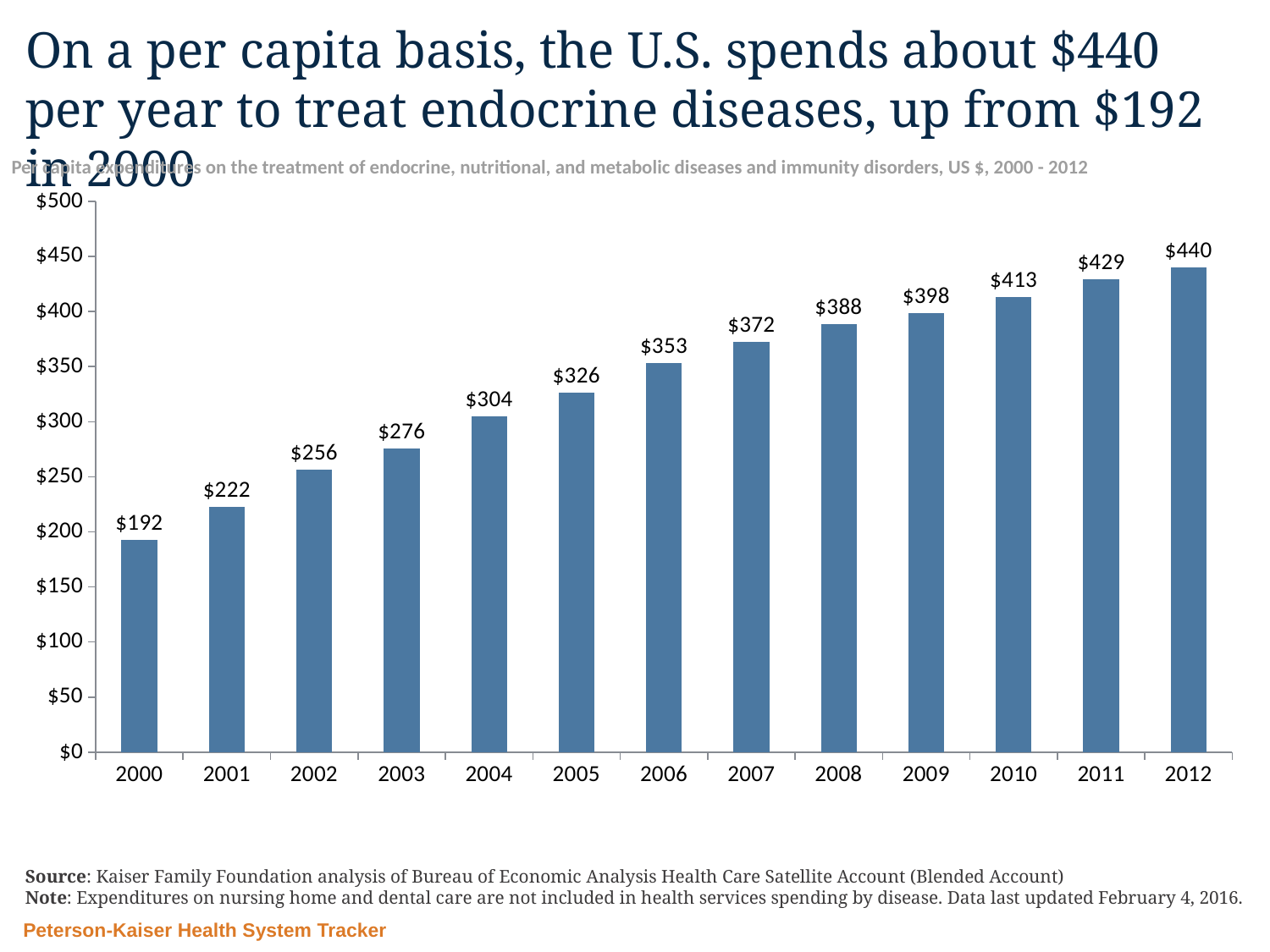
Do the values rise or fall from 2000 to 2012? Rise Which year has a larger value, 2003 or 2007? 2007 Which year has the highest per capita expenditure? 2012 Is the value for 2008 greater or less than $350? greater What is the per capita expenditure value shown for 2009? $398 What kind of chart is shown on the slide? Bar chart How many years are shown on the x axis? 13 What is the difference between the values for 2006 and 2005? $27 What is the difference between the values for 2012 and 2000? $248 What is the per capita expenditure value shown for 2004? $304 What is the maximum value shown on the y axis? $500 Which year has the lowest per capita expenditure? 2000